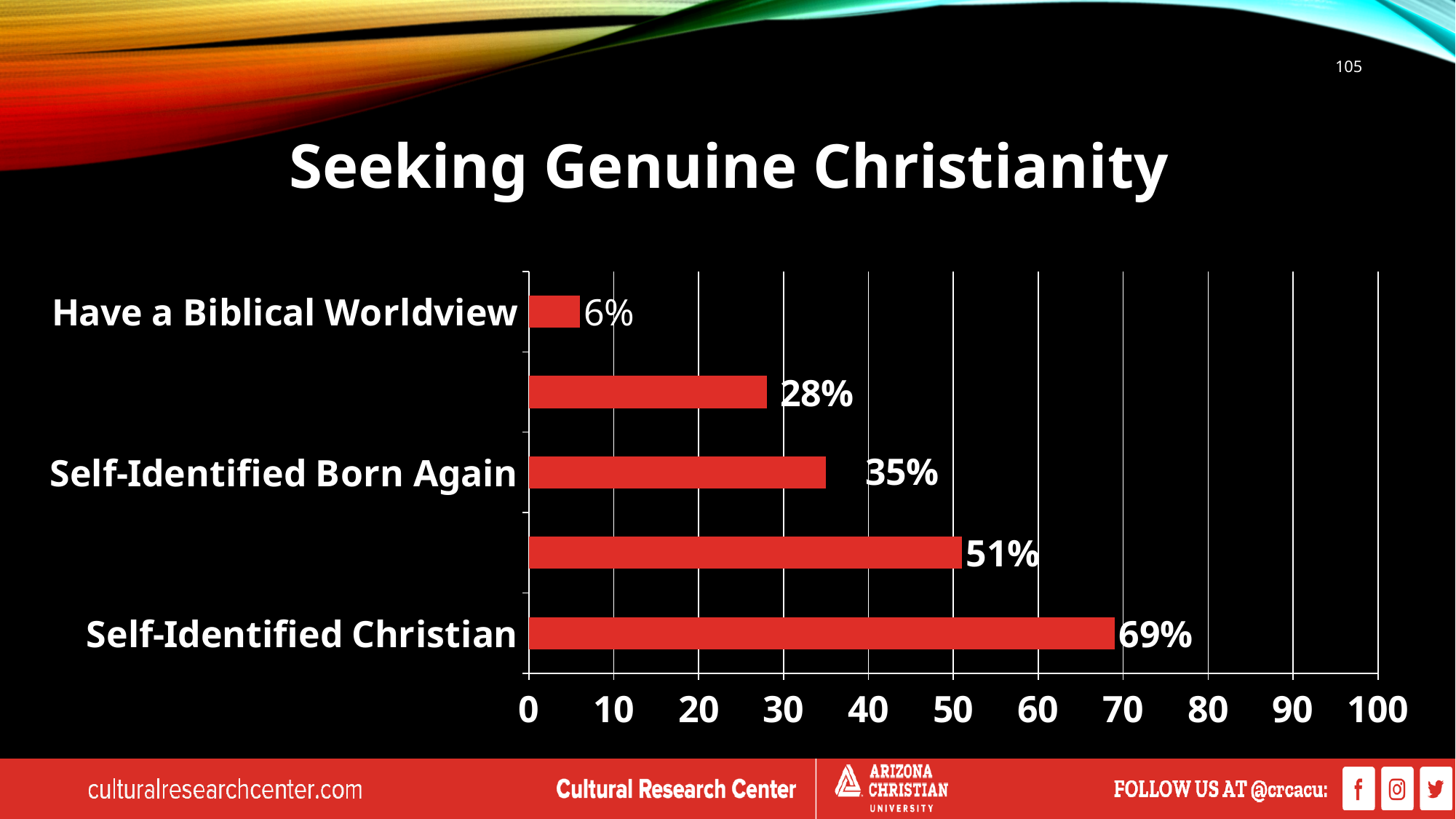
What is the difference between the values for Self-Identified Christian and Self-Identified Born Again? 34 percentage points What is the title of the chart? Seeking Genuine Christianity What kind of chart is shown on the slide? Bar chart Which category has the lowest value? Have a Biblical Worldview What is the difference between the values for Self-Identified Born Again and Have a Biblical Worldview? 29 percentage points Which category has the highest value? Self-Identified Christian Which is larger, the value for Self-Identified Born Again or the value for Have a Biblical Worldview? Self-Identified Born Again What is the value for Have a Biblical Worldview? 6% What is the value for Self-Identified Christian? 69% Is the value for Self-Identified Christian greater or less than 60? greater How many bars are plotted in the chart? 5 What is the value for Self-Identified Born Again? 35%